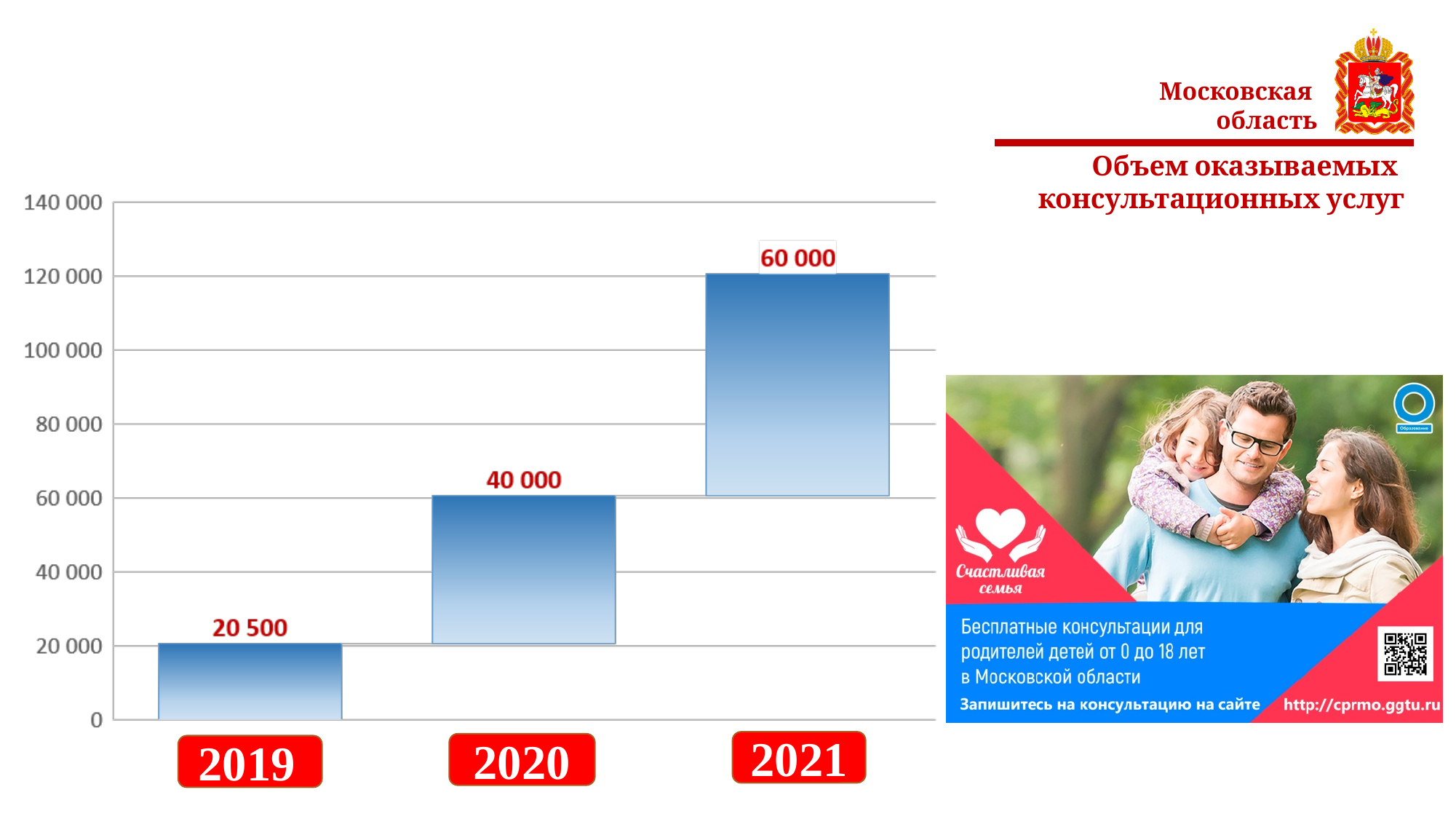
What is the difference between the labelled values for 2020 and 2019? 19 500 What is the data label for 2020? 40 000 What is the title shown above the chart on the slide? Объем оказываемых консультационных услуг Which year has the lowest labelled value? 2019 Which is larger, the labelled value for 2019 or for 2020? 2020 What is the data label for 2019? 20 500 What kind of chart is shown on the slide? bar chart What is the data label for 2021? 60 000 Do the labelled values rise or fall from 2019 to 2021? rise Which year has the highest labelled value? 2021 How many years are shown on the x axis? 3 What is the difference between the labelled values for 2021 and 2020? 20 000